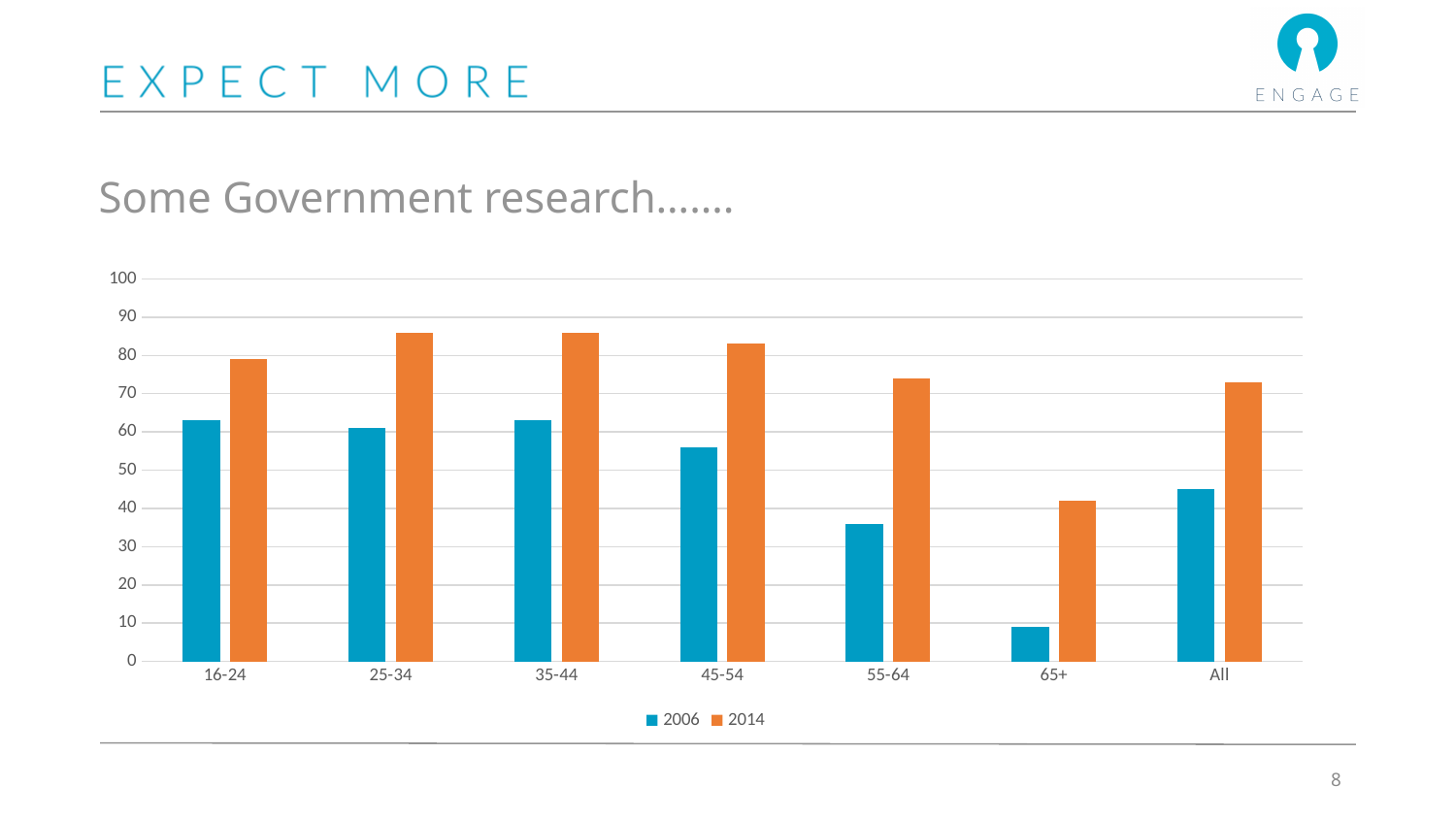
Is the 2006 value for 45-54 greater or less than 50? greater Which category has the lowest value for the 2006 series? 65+ What kind of chart is shown on the slide? bar chart Which category has the lowest value for the 2014 series? 65+ In the 2006 series, which is larger, the value for 16-24 or the value for 55-64? 16-24 How many series does the legend list? 2 How many categories are shown on the x axis? 7 Do the 2006 values rise or fall from 35-44 through 65+? fall Is the 2014 value for 16-24 greater or less than 70? greater Is the 2006 value for 55-64 greater or less than 40? less For the 45-54 category, which series has the larger value, 2006 or 2014? 2014